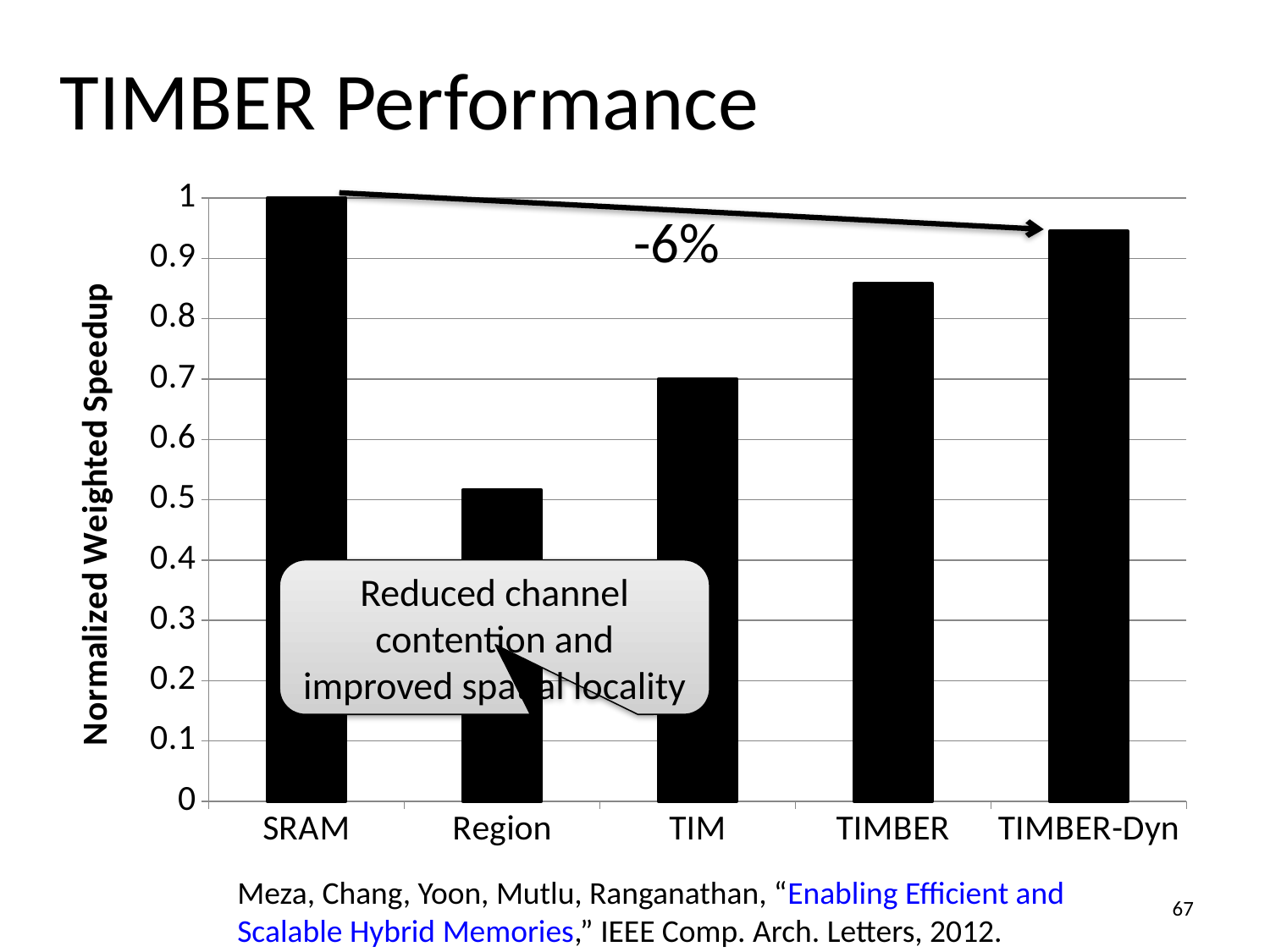
Is the value for TIMBER greater or less than 0.8? greater How many categories are plotted on the x axis of the chart? 5 What is the Normalized Weighted Speedup for SRAM? 1 What kind of chart is shown on the slide? bar chart Is the value for TIMBER-Dyn greater or less than 0.9? greater Which has a higher Normalized Weighted Speedup, Region or TIM? TIM What is the title of the y axis of the chart? Normalized Weighted Speedup Which has a higher Normalized Weighted Speedup, TIM or TIMBER? TIMBER Is the value for TIM greater or less than 0.6? greater Which category has the highest Normalized Weighted Speedup? SRAM Which category has the lowest Normalized Weighted Speedup? Region